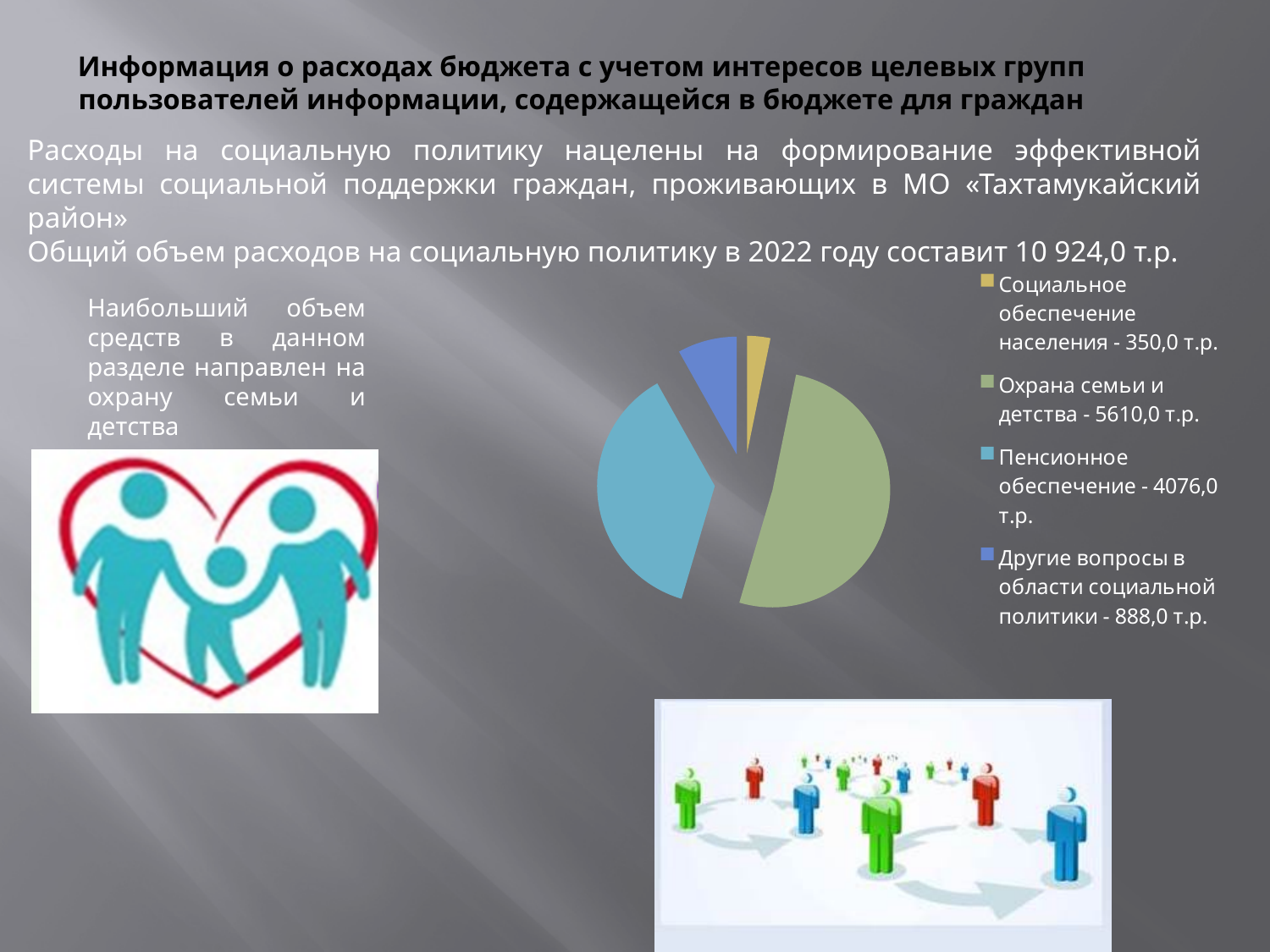
Which category has the smallest slice in the pie chart? Социальное обеспечение населения What colour is the slice for Охрана семьи и детства? green Which is larger: Пенсионное обеспечение or Другие вопросы в области социальной политики? Пенсионное обеспечение What is the value for Пенсионное обеспечение in the pie chart legend? 4076,0 т.р. What is the difference between Охрана семьи и детства and Пенсионное обеспечение? 1534,0 т.р. What kind of chart is shown on the slide? pie chart How many slices does the pie chart have? 4 Which category has the largest slice in the pie chart? Охрана семьи и детства What is the value for Социальное обеспечение населения in the pie chart legend? 350,0 т.р. What is the value for Другие вопросы в области социальной политики in the pie chart legend? 888,0 т.р. What is the total of all four categories in the pie chart? 10 924,0 т.р. What is the value for Охрана семьи и детства in the pie chart legend? 5610,0 т.р.